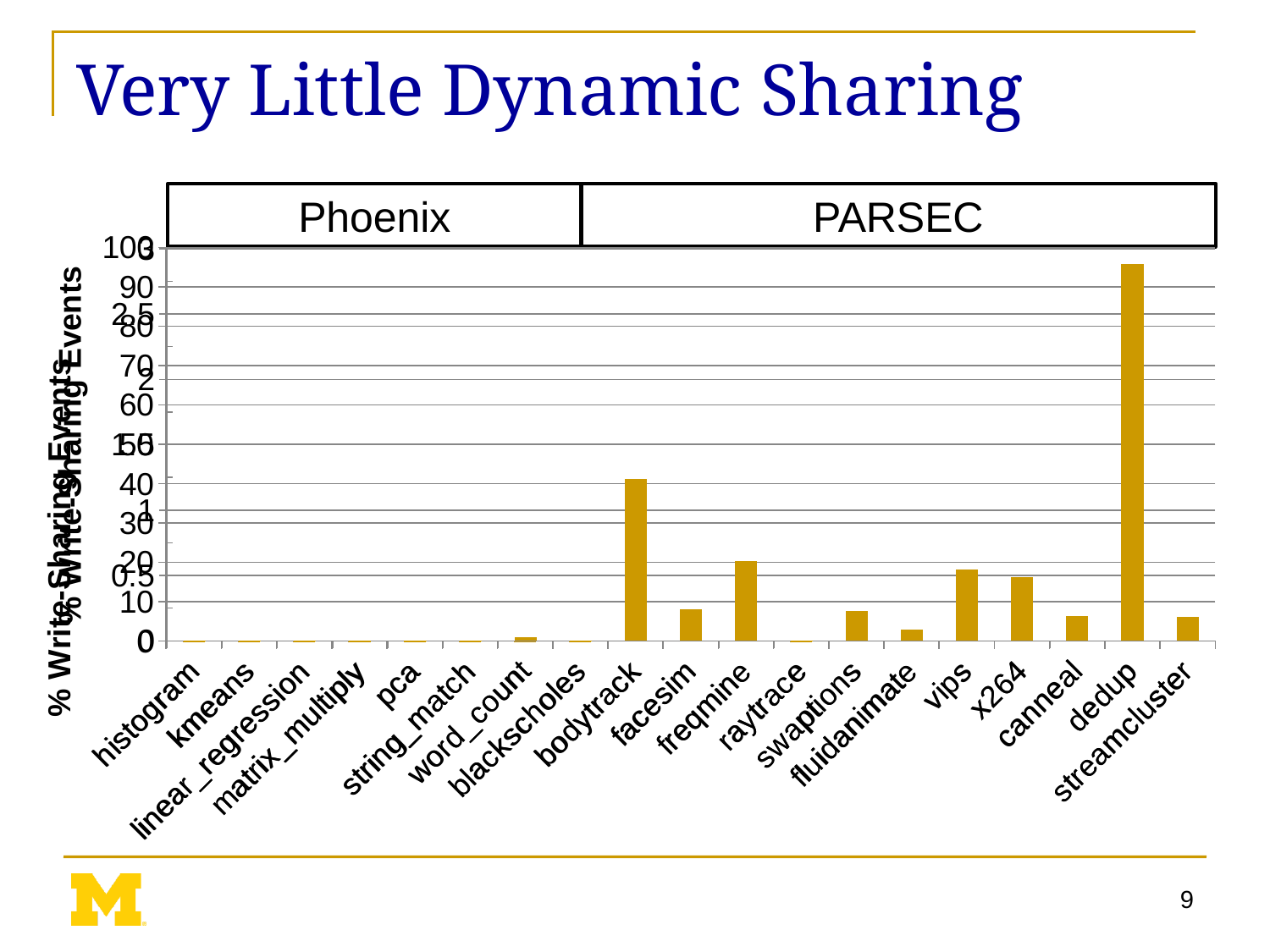
Which has a larger value, dedup or bodytrack? dedup Is the value for vips greater or less than 30? less Which two benchmark suites are labelled above the chart? Phoenix and PARSEC Is the value for fluidanimate greater or less than 10? less Is the value for freqmine greater or less than 30? less Which has a larger value, bodytrack or freqmine? bodytrack What colour are the bars in the chart? gold Which benchmark has the highest percentage of write-sharing events? dedup What kind of chart is shown on the slide? bar chart How many benchmarks are listed along the x axis? 19